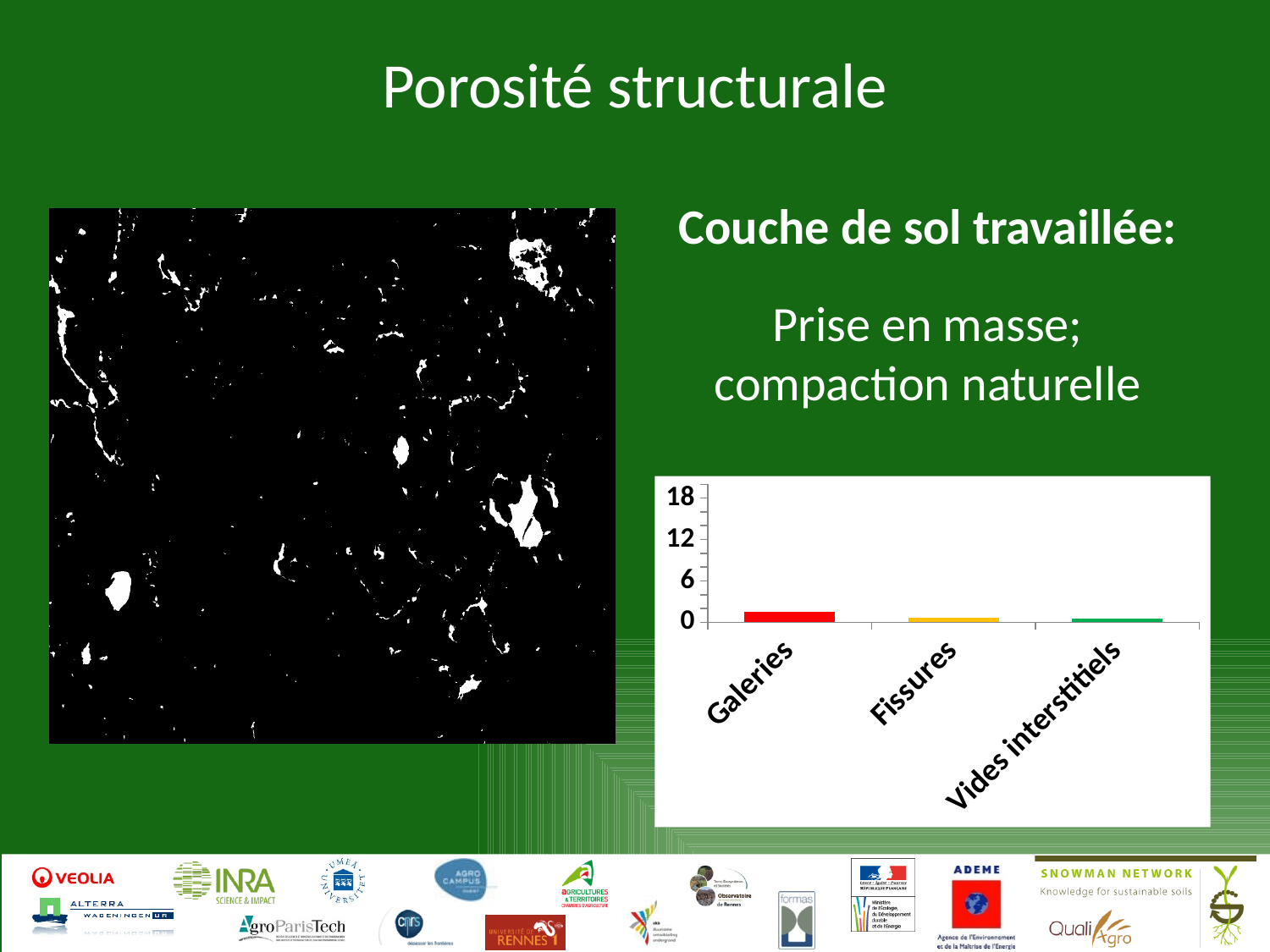
How many categories are shown on the x axis of the chart? 3 What is the highest tick value shown on the y axis of the chart? 18 Is the value for Vides interstitiels greater or less than 6? less Is the value for Galeries greater or less than 6? less Which is larger, the value for Galeries or the value for Vides interstitiels? Galeries Which is larger, the value for Galeries or the value for Fissures? Galeries What kind of chart is shown on the slide? bar chart Is the value for Fissures greater or less than 6? less What colour is the bar for Galeries? red Which category has the highest bar in the chart? Galeries